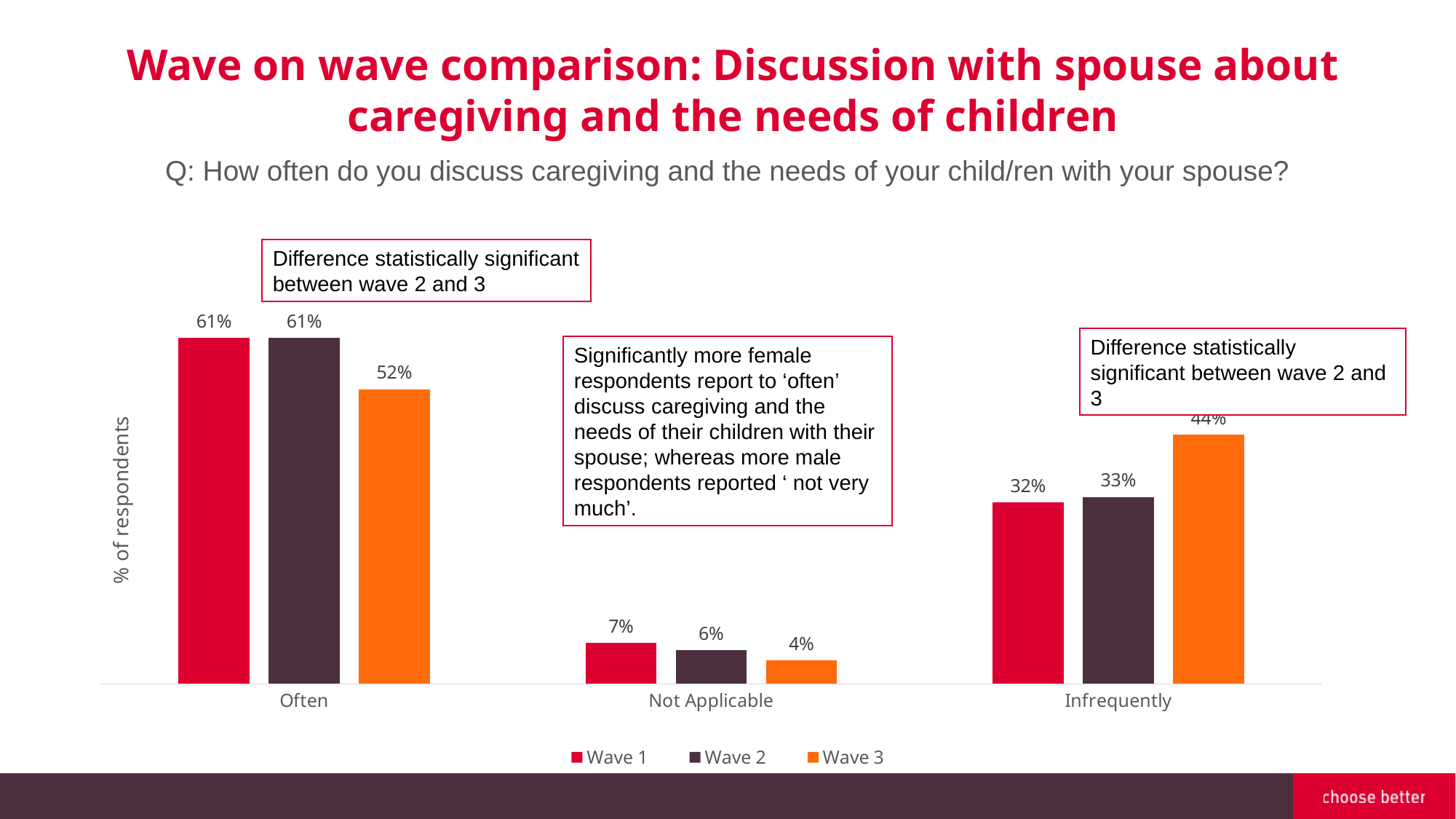
Which category has the lowest Wave 1 value? Not Applicable What is the difference between the Wave 2 and Wave 3 values for 'Often'? 9% What is the difference between the Wave 3 and Wave 2 values for 'Infrequently'? 11% Which is larger for 'Infrequently': the Wave 1 value or the Wave 3 value? Wave 3 Which category has the highest Wave 3 value? Often What percentage of respondents in Wave 3 said they discuss caregiving 'Often'? 52% What is the Wave 1 value for the 'Infrequently' category? 32% How many series does the legend list? 3 What colour represents Wave 3 in the chart? Orange How many response categories are shown on the x axis? 3 What kind of chart is shown on the slide? Bar chart What is the Wave 2 value for 'Not Applicable'? 6%